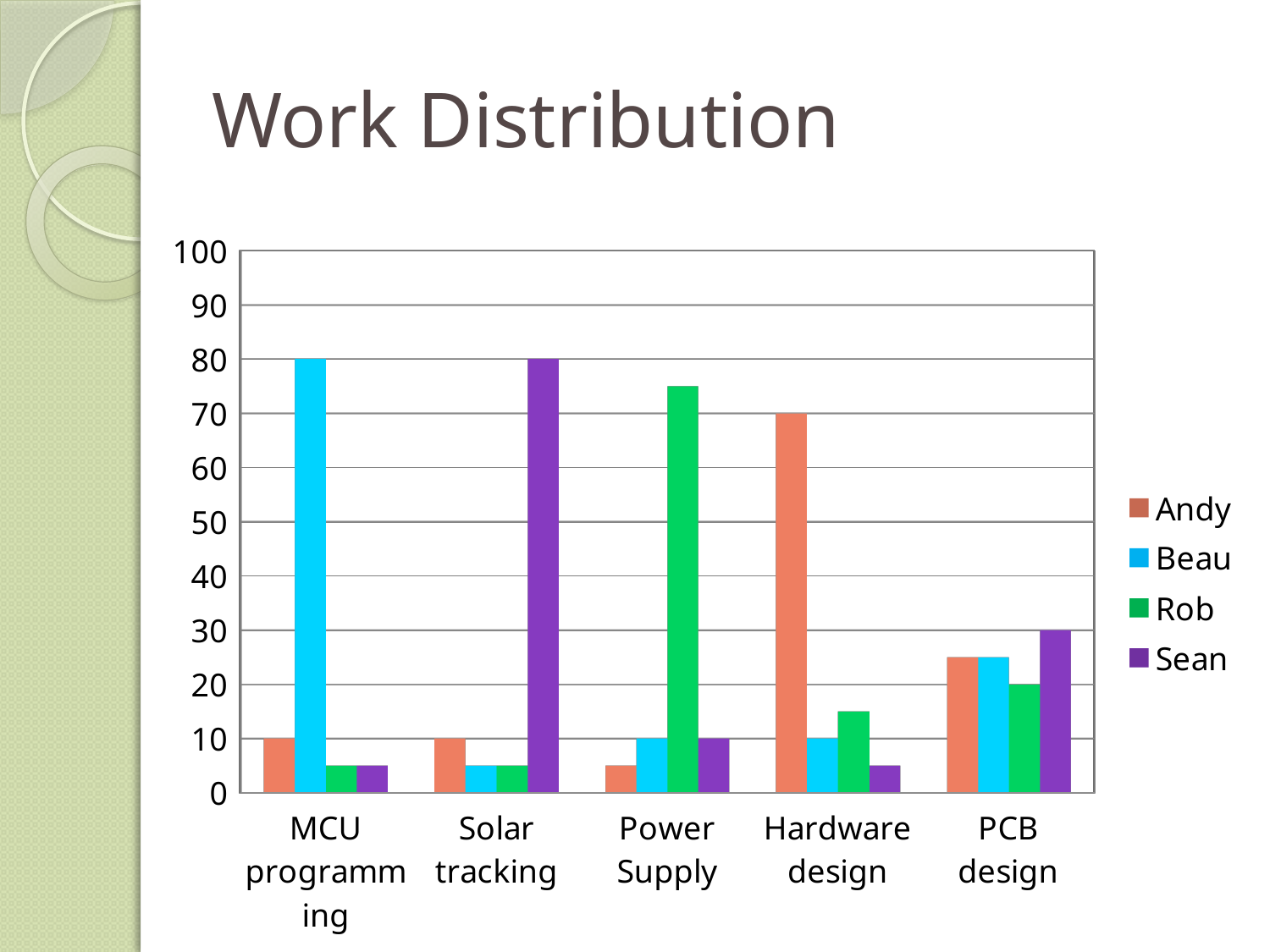
What is the value for Andy in Hardware design? 70 How many series does the legend list? 4 What kind of chart is shown on the slide? bar chart What is the value for Beau in MCU programming? 80 Which series has the lowest value in Hardware design? Sean What is the difference between Beau's value in MCU programming and Andy's value in Hardware design? 10 What is the value for Sean in Solar tracking? 80 Which series has the highest value in Power Supply? Rob How many categories are shown on the x axis? 5 Is the value for Rob in Power Supply greater or less than 70? greater What is the value for Sean in PCB design? 30 Which is larger in PCB design, the value for Rob or the value for Sean? Sean